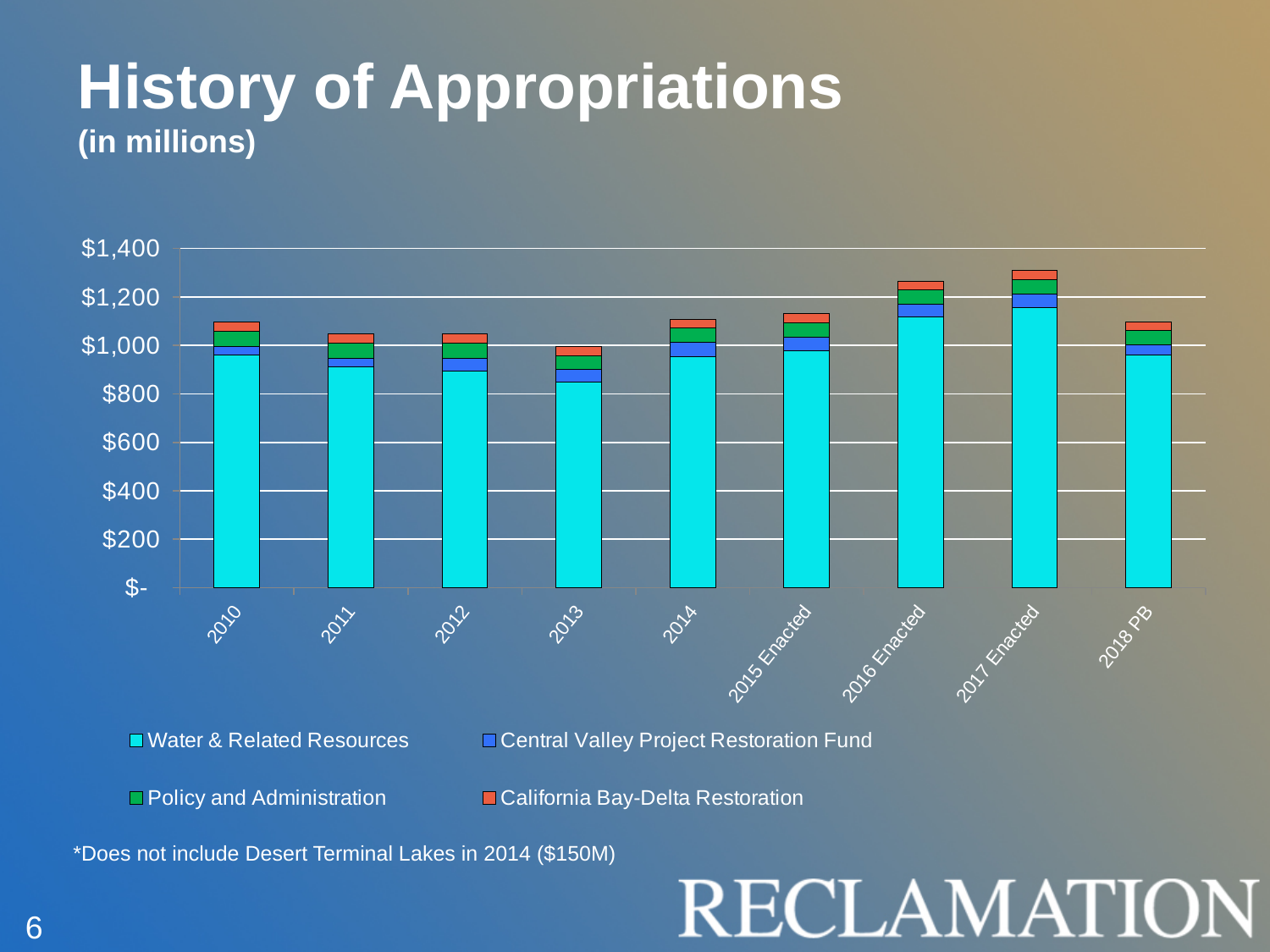
Do the total appropriations rise or fall from 2013 to 2017 Enacted? rise Is the Water & Related Resources value for 2017 Enacted greater or less than $1,000? greater What kind of chart is shown on the slide? Stacked bar chart Which category has the lowest total appropriation? 2013 Which category has the highest total appropriation? 2017 Enacted Is the total for 2010 greater or less than $1,200? less How many series does the legend list? 4 Which series is shown at the bottom of each stacked bar? Water & Related Resources How many categories are shown along the x axis? 9 Which has the larger total, 2017 Enacted or 2018 PB? 2017 Enacted Is the Water & Related Resources value for 2013 greater or less than $800? greater